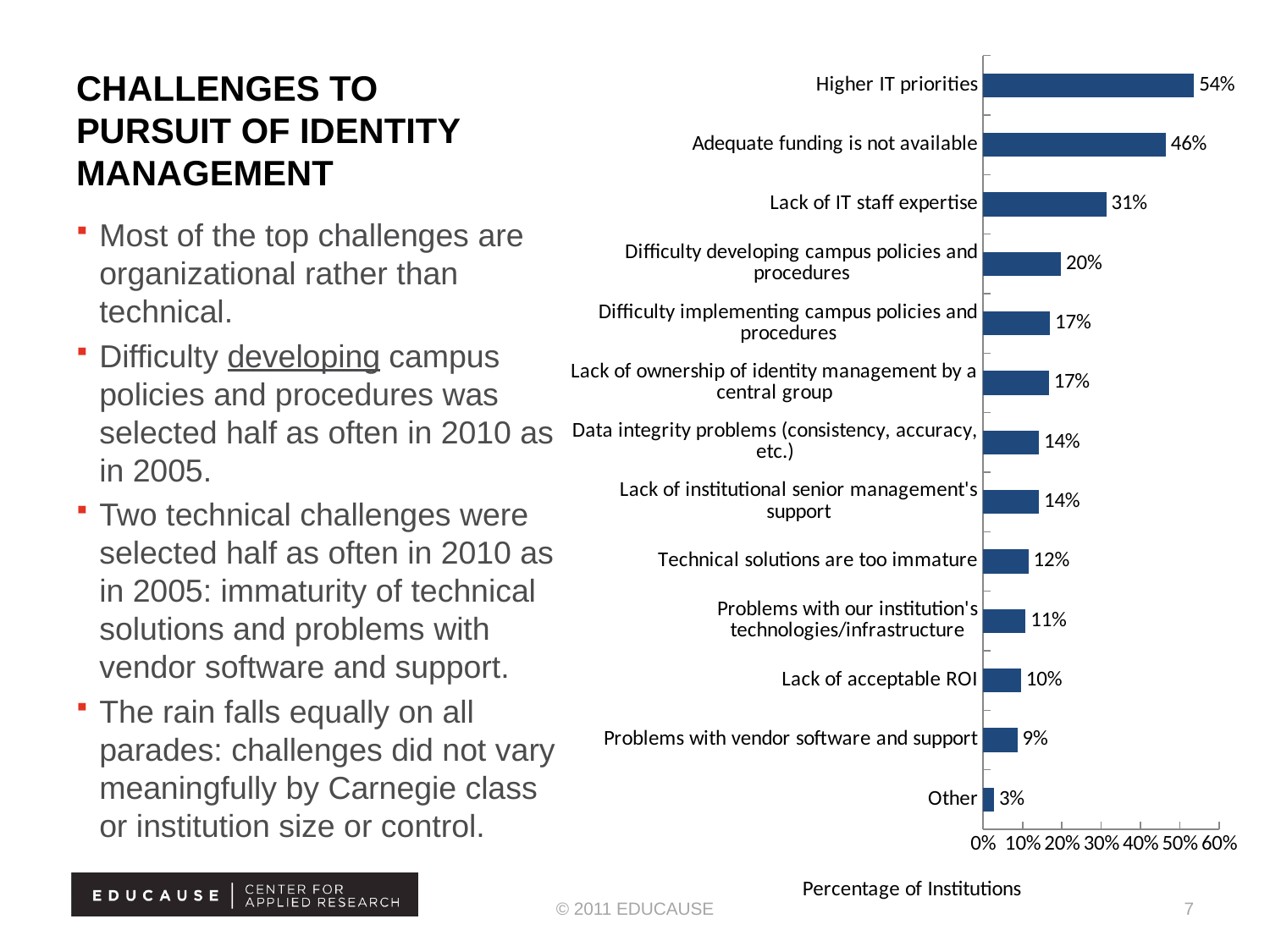
Which category has the lowest value on the chart? Other What is the value for "Lack of IT staff expertise"? 31% What kind of chart is shown on the slide? Bar chart How many categories are plotted on the chart? 13 What is the label of the horizontal axis? Percentage of Institutions What is the value for "Lack of acceptable ROI"? 10% What percentage is shown for "Problems with vendor software and support"? 9% Which challenge has the highest percentage of institutions? Higher IT priorities What is the difference between "Higher IT priorities" and "Adequate funding is not available"? 8% What percentage of institutions selected "Higher IT priorities" as a challenge? 54% What is the difference between "Lack of IT staff expertise" and "Lack of acceptable ROI"? 21% Which is larger: "Difficulty developing campus policies and procedures" or "Technical solutions are too immature"? Difficulty developing campus policies and procedures